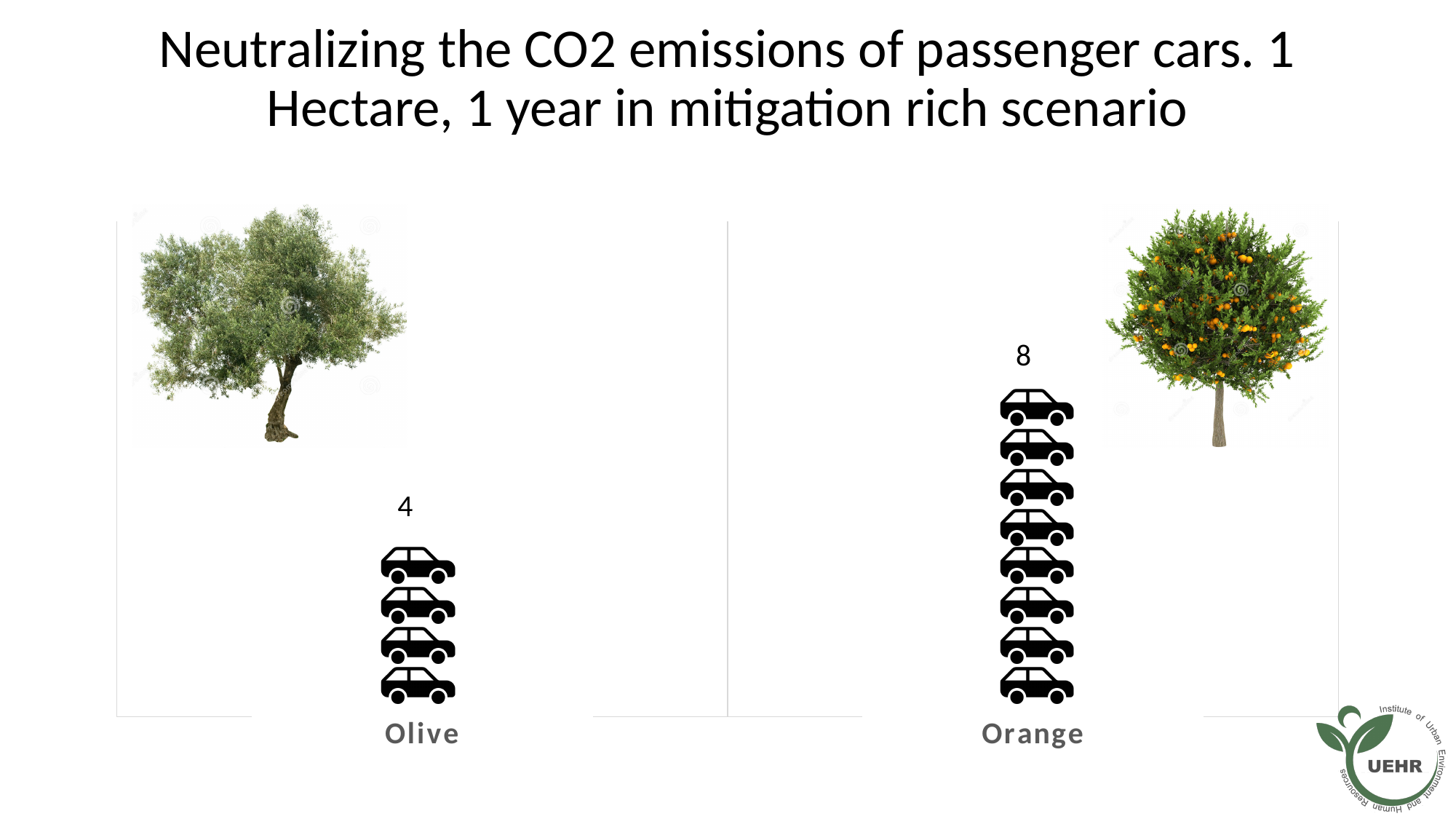
What is the value shown for Olive? 4 What is the title of the slide? Neutralizing the CO2 emissions of passenger cars. 1 Hectare, 1 year in mitigation rich scenario Which category has the lowest value? Olive Which category has the highest value? Orange What is the difference between the values for Orange and Olive? 4 How many car icons are stacked for Orange? 8 How many car icons are stacked for Olive? 4 Which category has the higher value, Olive or Orange? Orange How many categories are shown on the slide? 2 What is the value shown for Orange? 8 What icon is used to represent the values in the chart? A car